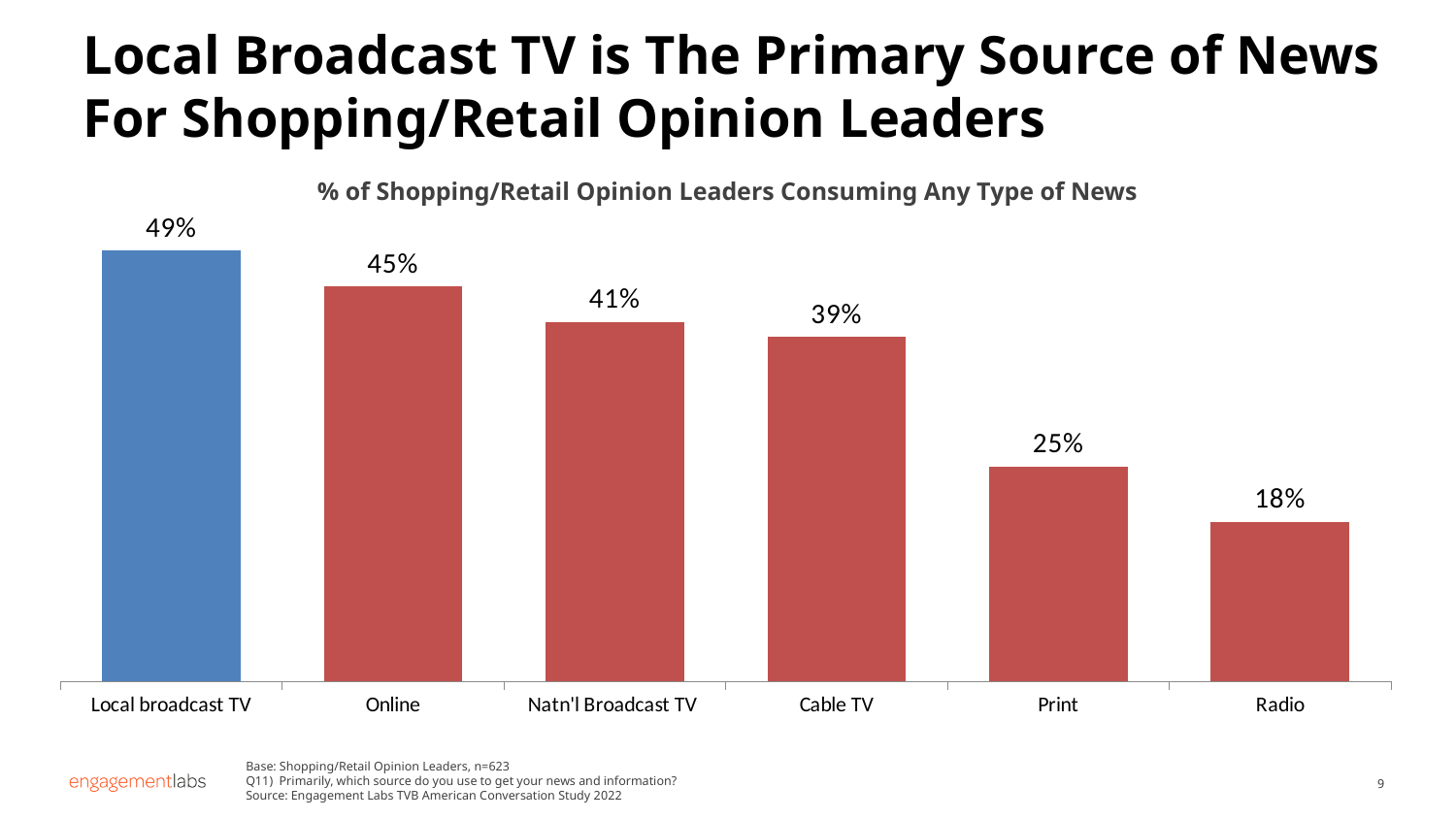
What is the value for Radio? 18% What is the value for Local broadcast TV? 49% Which category has the lowest value? Radio What is the title of the chart? % of Shopping/Retail Opinion Leaders Consuming Any Type of News Which category has the highest value? Local broadcast TV What is the value for Cable TV? 39% Which is larger, the value for Natn'l Broadcast TV or the value for Cable TV? Natn'l Broadcast TV What is the difference between the values for Print and Radio? 7% What is the difference between the values for Local broadcast TV and Online? 4% How many categories are shown in the chart? 6 What kind of chart is shown on the slide? Bar chart What is the value for Online? 45%